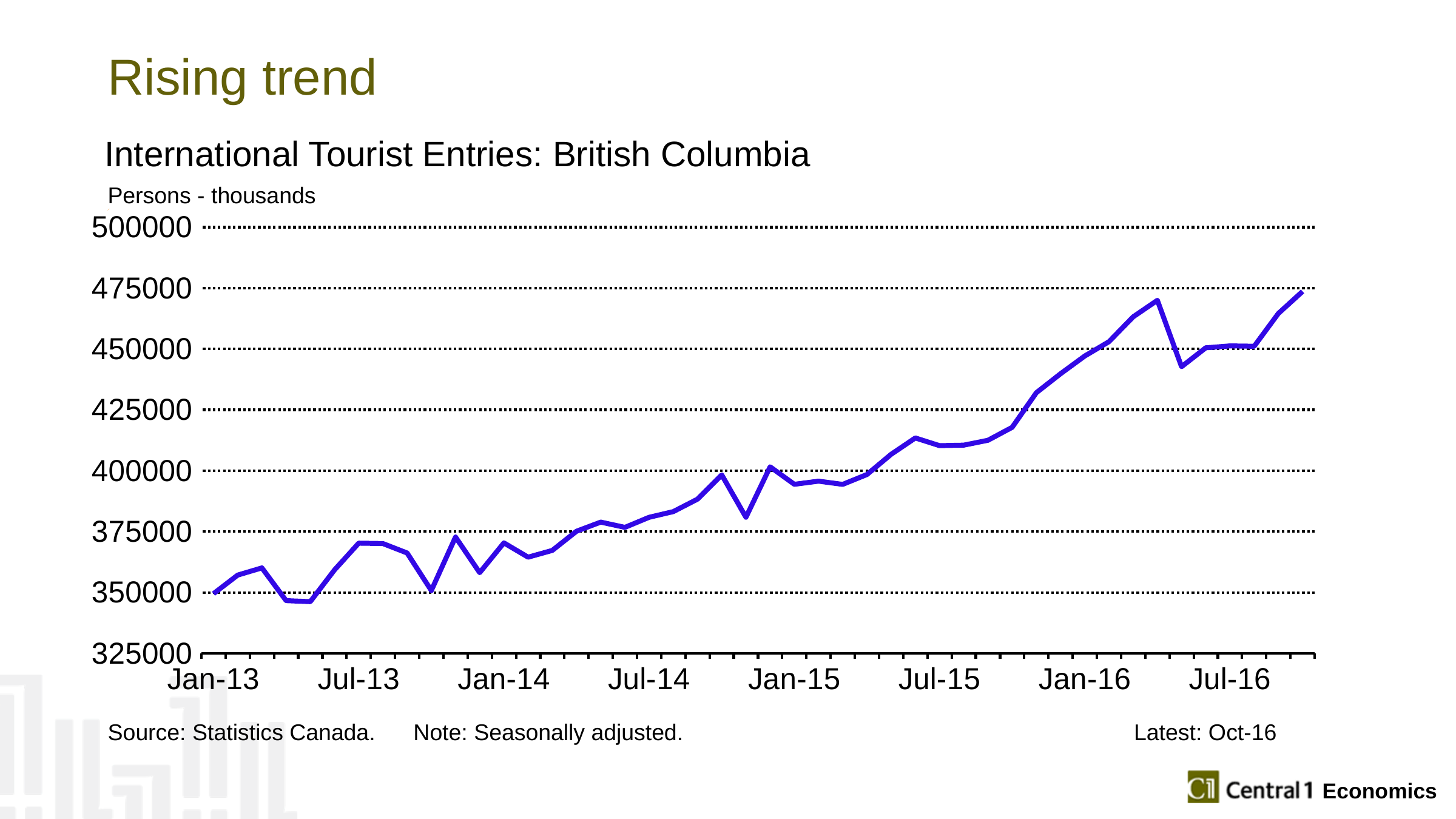
Is the value for Jul-15 greater or less than 400000? greater What unit is shown on the y axis of the chart? Persons - thousands Do the values generally rise or fall from Jan-13 to the end of the series? rise Which is larger, the value for Jan-14 or the value for Jan-16? Jan-16 Is the value for Jan-16 greater or less than 425000? greater Is the value for Jan-13 greater or less than 375000? less What is the title of the chart? International Tourist Entries: British Columbia What kind of chart is shown on the slide? line chart How many data series are plotted on the chart? 1 Which is larger, the value for Jan-13 or the value for Jul-16? Jul-16